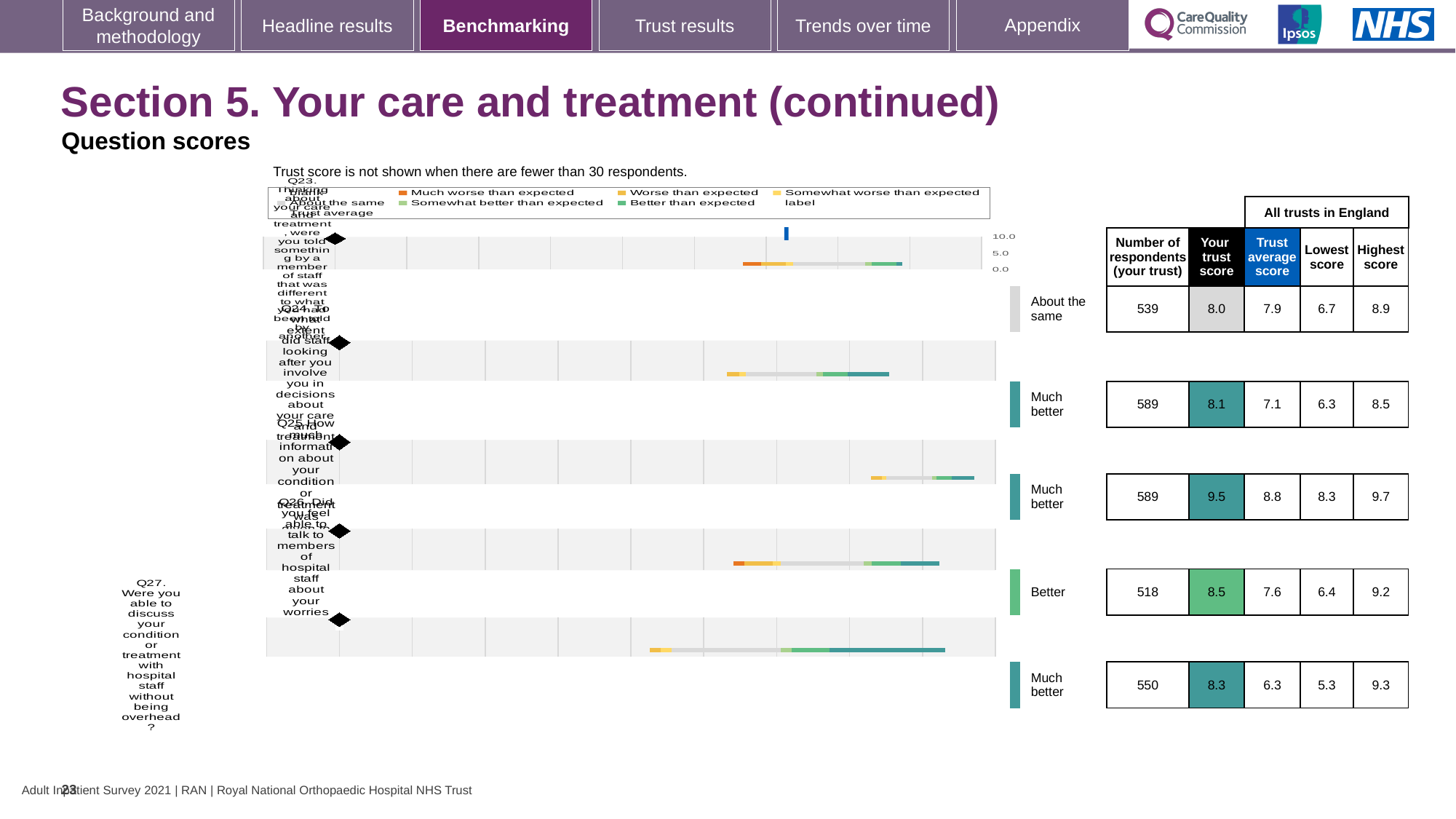
For Q24, which is larger: your trust score or the trust average score? Your trust score How many questions are plotted on this slide's chart? 5 What is the highest 'Your trust score' shown in the table on this slide? 9.5 How many respondents from your trust answered Q27? 550 What is the highest score across all trusts in England for Q26? 9.2 Is the trust score marker for Q27 on the chart greater or less than 5.0? greater What is the difference between your trust score and the trust average score for Q27? 2.0 Which question has the lowest 'Lowest score' value in the table? Q27 What benchmark category is shown for Q23, the first question on the chart? About the same What is the trust average score for Q27? 6.3 What is the trust score for Q27 (Were you able to discuss your condition or treatment with hospital staff without being overheard?)? 8.3 What benchmark category is shown for Q26? Better